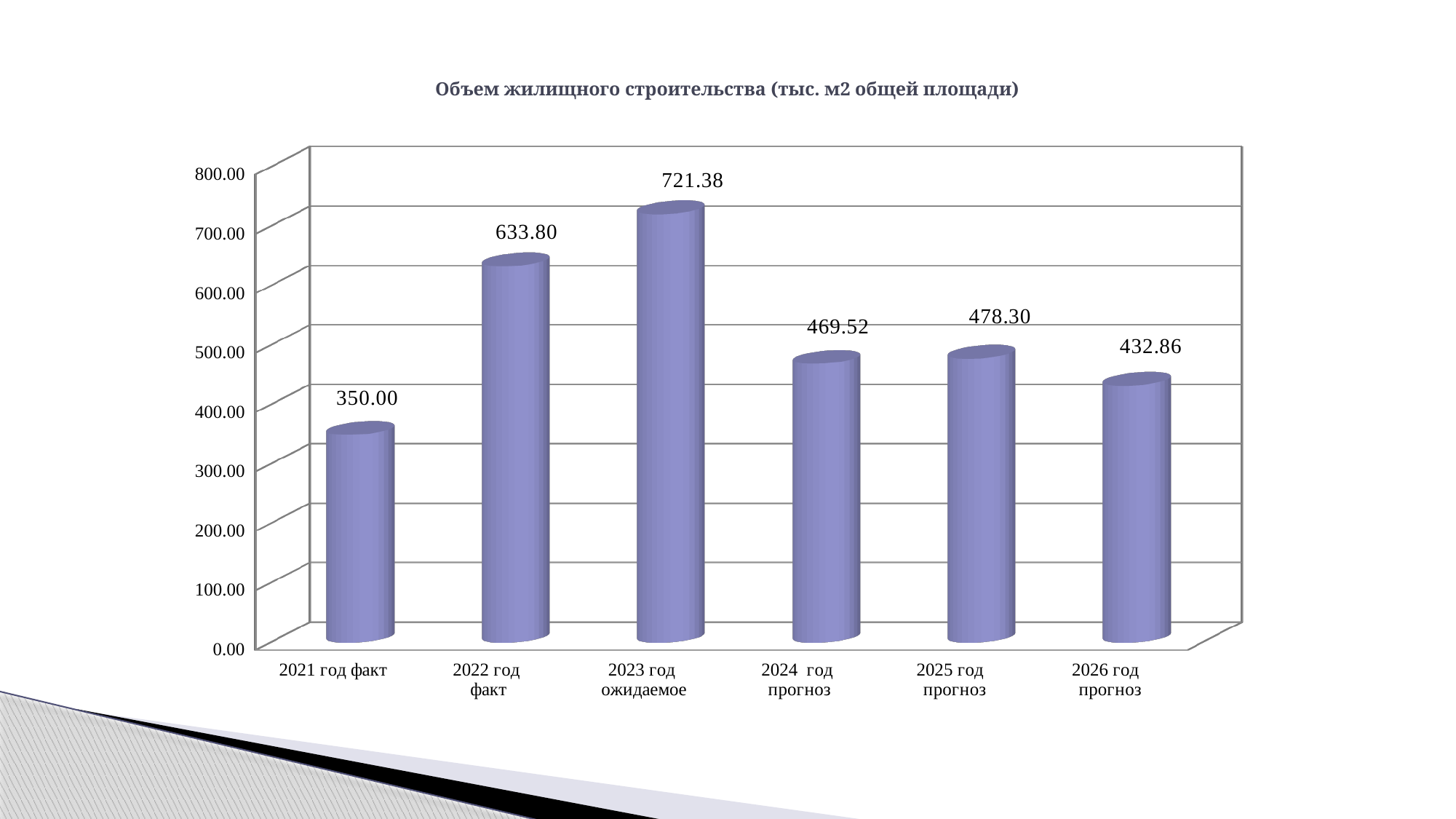
Do the values rise or fall from 2021 год факт to 2023 год ожидаемое? rise What is the title of the chart? Объем жилищного строительства (тыс. м2 общей площади) What is the value for 2021 год факт? 350.00 What is the value for 2023 год ожидаемое? 721.38 What kind of chart is this? bar chart Which category has the lowest value? 2021 год факт How many categories are shown on the x axis? 6 What is the value for 2025 год прогноз? 478.30 Which is larger, the value for 2024 год прогноз or 2026 год прогноз? 2024 год прогноз Is the value for 2022 год факт greater or less than 600.00? greater Which category has the highest value? 2023 год ожидаемое What is the difference between the values for 2023 год ожидаемое and 2022 год факт? 87.58